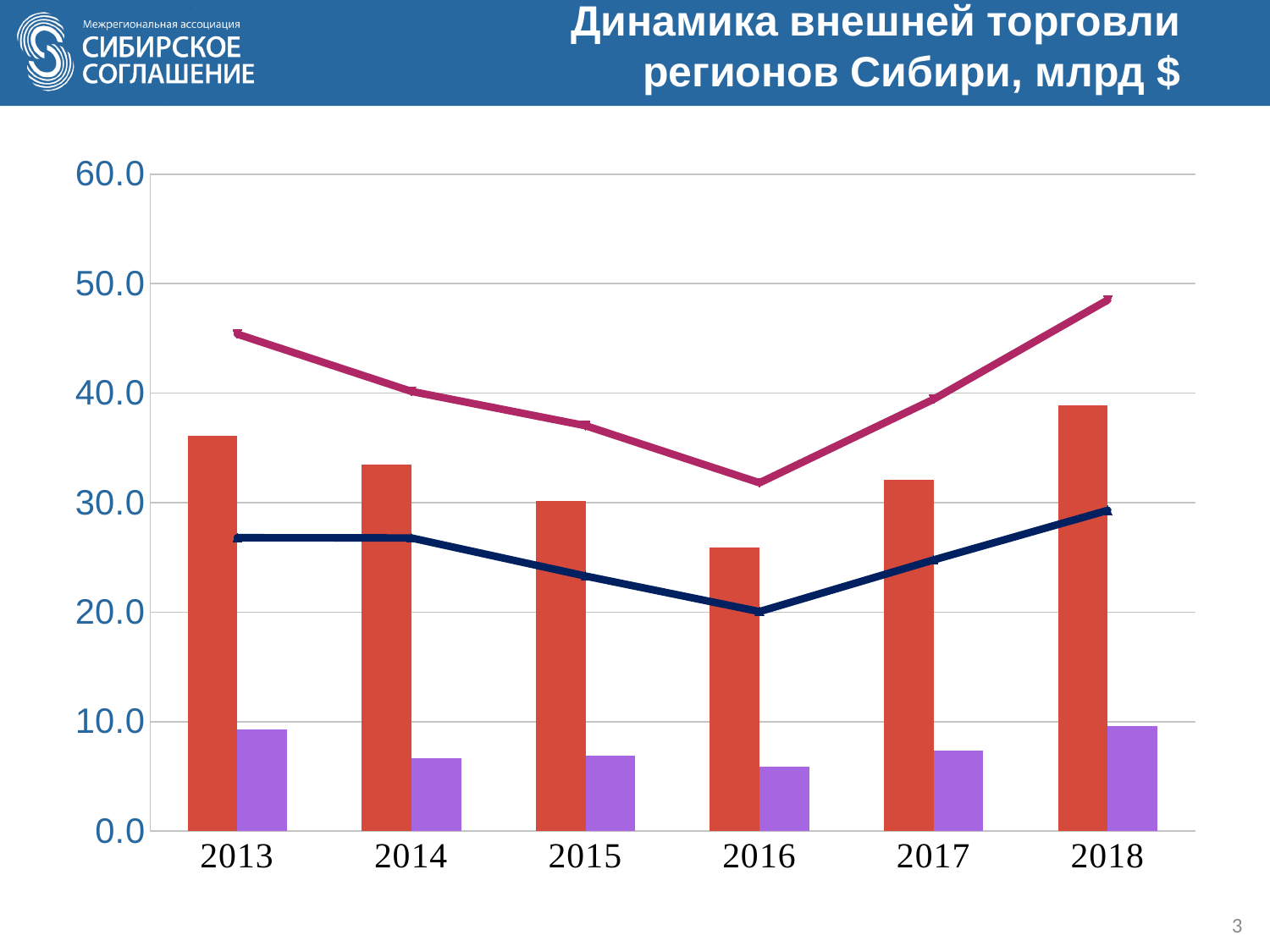
Is the value of the purple bar for 2013 greater or less than 10.0? less Which red bar is taller, 2013 or 2017? 2013 How many years are shown on the x axis of the chart? 6 In which year is the red bar the tallest? 2018 What is the title of the slide containing the chart? Динамика внешней торговли регионов Сибири, млрд $ In which year does the magenta (pink) line reach its lowest point? 2016 In which year does the magenta (pink) line reach its highest point? 2018 What kind of chart is shown on the slide? A combined bar and line chart In which year is the red bar the shortest? 2016 Does the magenta (pink) line rise or fall from 2013 to 2016? It falls Is the value of the magenta (pink) line for 2018 greater or less than 40.0? greater Is the value of the red bar for 2016 greater or less than 30.0? less